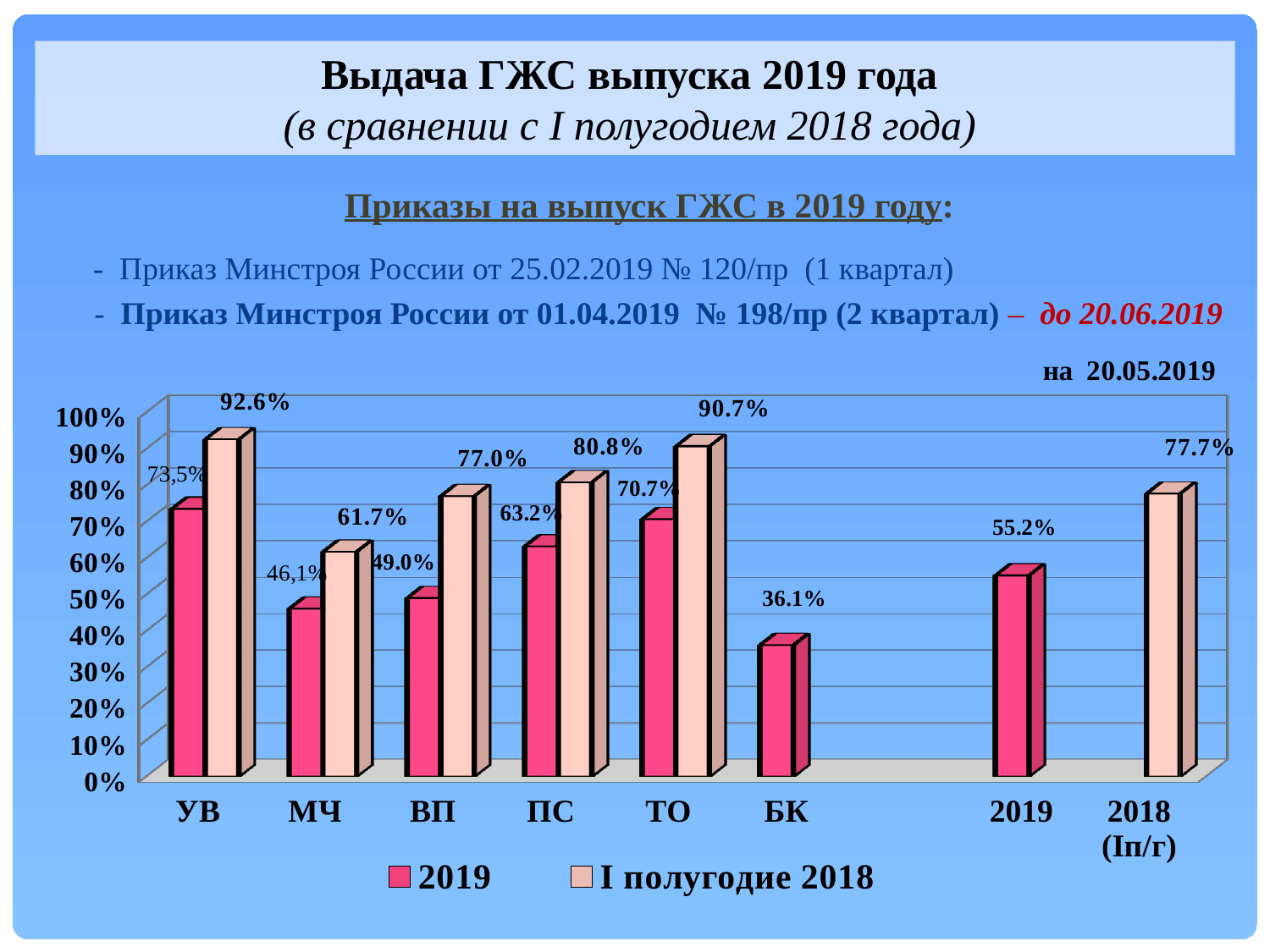
Which category has the lowest 2019 value? БК What is the difference between the I полугодие 2018 and 2019 values for ВП? 28.0% What is the value shown for the 2018 (Iп/г) category? 77.7% What is the 2019 value for УВ? 73,5% What is the difference between the I полугодие 2018 and 2019 values for ТО? 20.0% What is the 2019 value for ТО? 70.7% What is the 2019 value for БК? 36.1% What is the I полугодие 2018 value for ПС? 80.8% Which category has the highest I полугодие 2018 value? УВ How many series does the legend list? 2 What kind of chart is shown on the slide? Bar chart Which is larger: the 2019 value for ВП or the 2019 value for МЧ? ВП